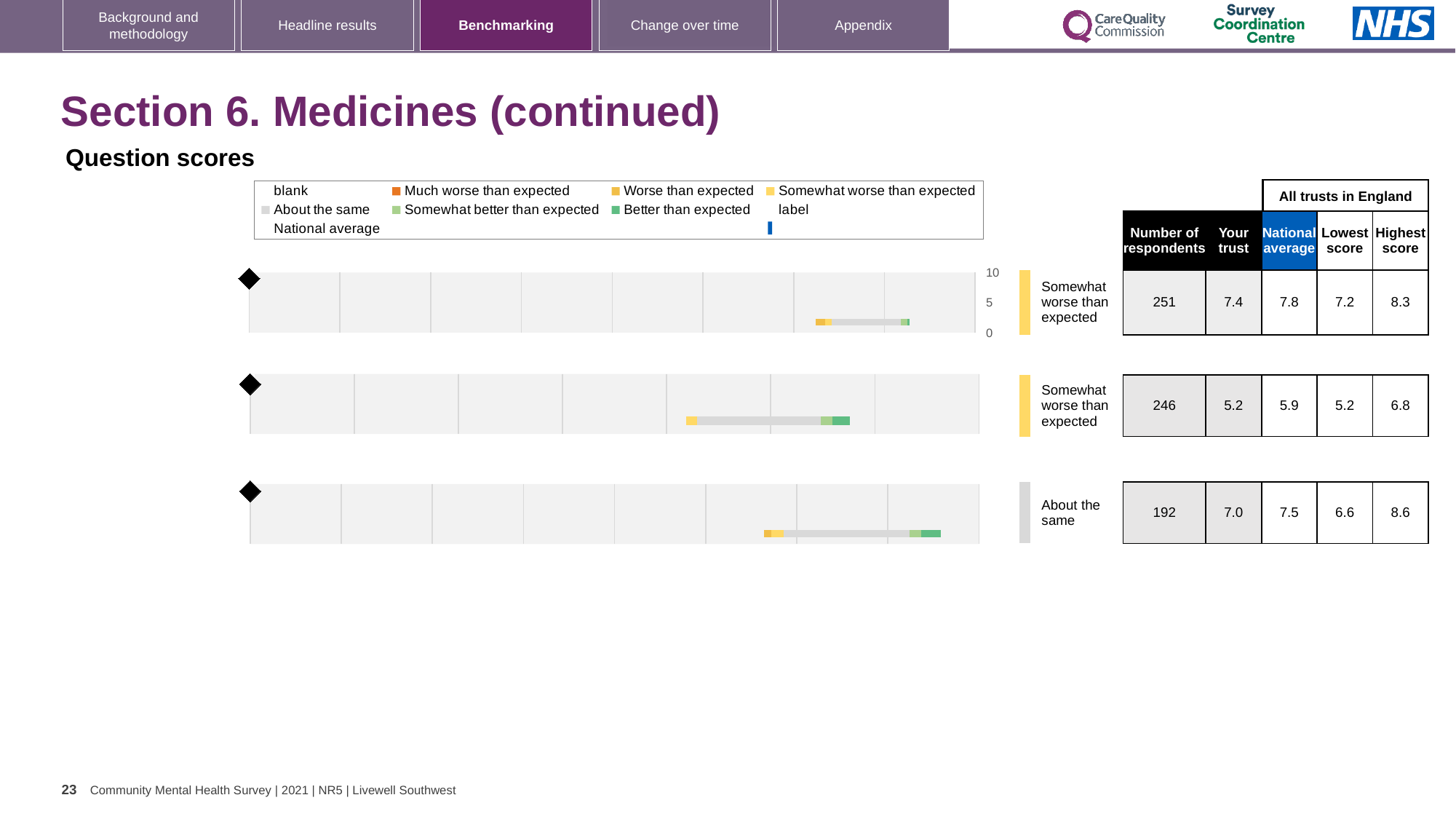
In the bottom chart, what is the Highest score among all trusts in England? 8.6 In the top chart, what is the score for Your trust? 7.4 How many charts are shown on the slide? 3 What benchmark rating is shown for the bottom chart? About the same Which of the three charts has the lowest Your trust score? The middle chart (5.2) In the top chart, what is the difference between the National average and the Your trust score? 0.4 In the bottom chart, which is larger: the Your trust score or the National average? National average In the middle chart, how many respondents are there? 246 In the top chart, what is the National average score? 7.8 Which of the three charts has the highest number of respondents? The top chart (251) In the middle chart, what is the Lowest score among all trusts in England? 5.2 What benchmark rating is shown for the top chart? Somewhat worse than expected